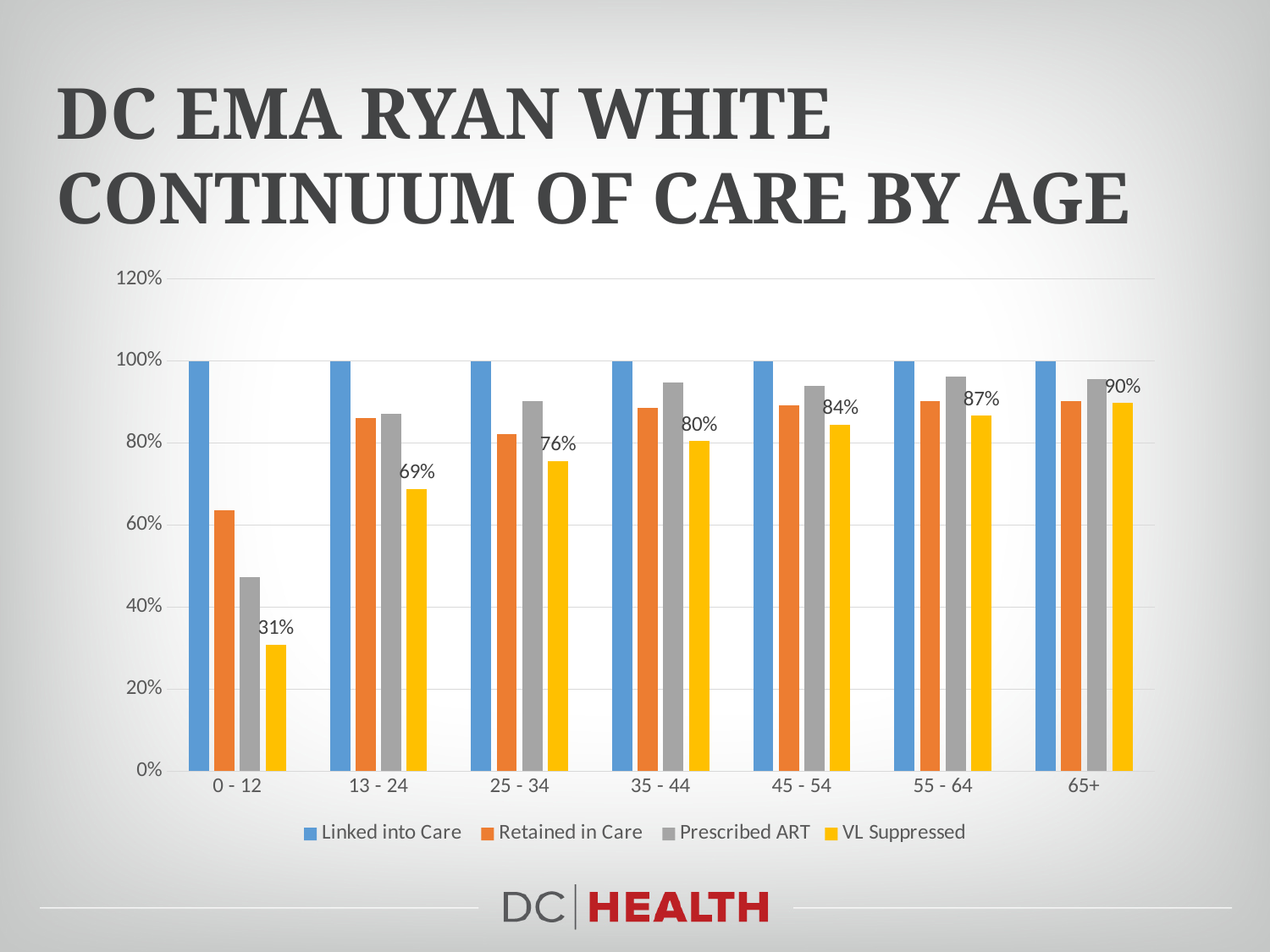
Is the Prescribed ART value for the 55 - 64 age group greater or less than 80%? greater Which age group has the highest VL Suppressed value? 65+ What is the VL Suppressed value for the 0 - 12 age group? 31% Is the Retained in Care value for the 0 - 12 age group greater or less than 80%? less What is the difference between the VL Suppressed values for the 65+ and 0 - 12 age groups? 59% Which is larger, the VL Suppressed value for 45 - 54 or for 25 - 34? 45 - 54 What is the VL Suppressed value for the 65+ age group? 90% Do the VL Suppressed values rise or fall as age group increases along the x axis? rise What is the VL Suppressed value for the 35 - 44 age group? 80% How many series does the legend list? 4 Which age group has the lowest VL Suppressed value? 0 - 12 How many age groups are shown on the x axis? 7